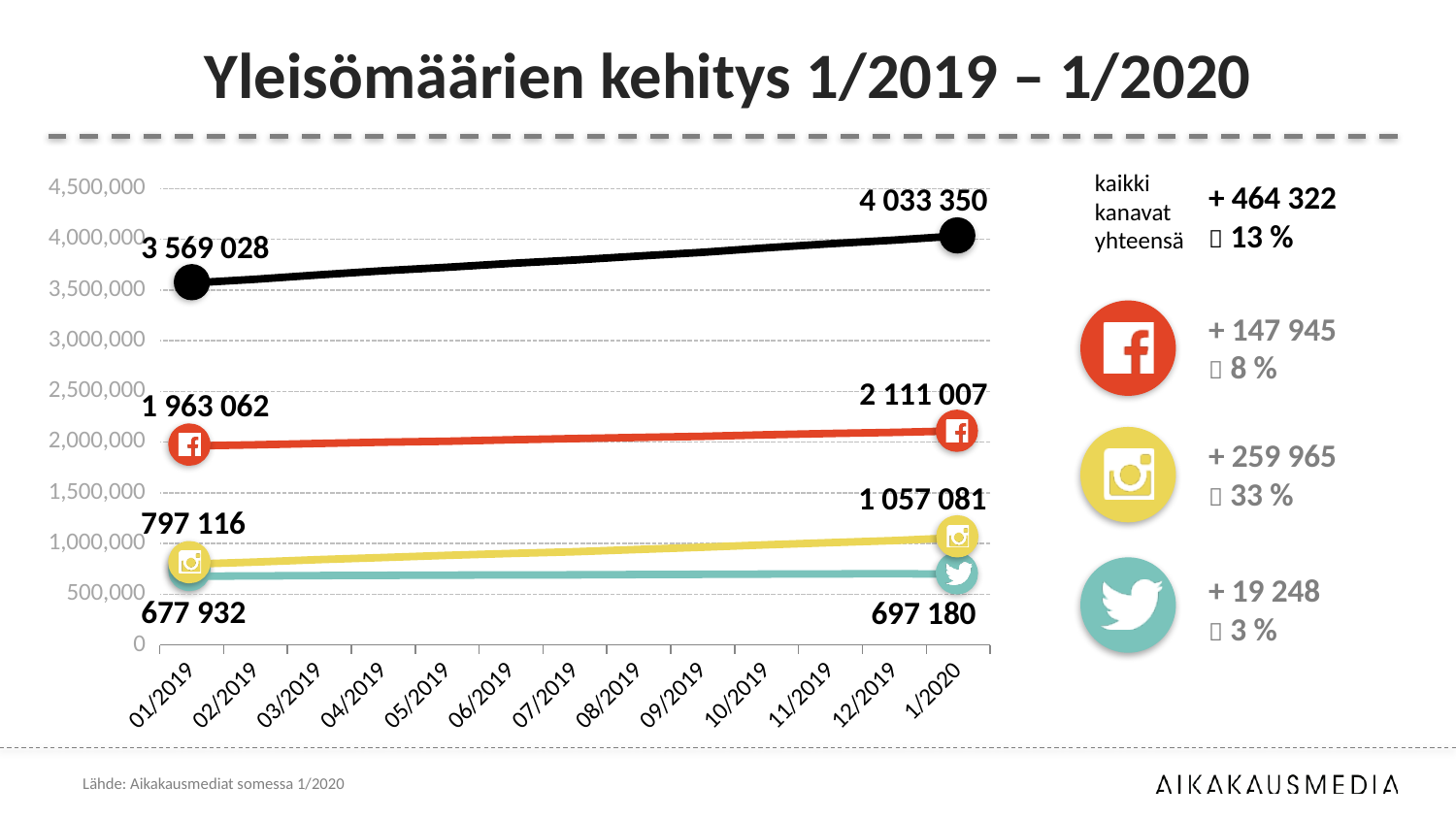
Which line has the lowest value at 1/2020? Twitter (697 180) At 1/2020, which is larger: the Facebook value or the Instagram value? Facebook (2 111 007) By how much did the Instagram line increase from 01/2019 to 1/2020? 259 965 How many time points are labelled on the x axis? 13 What is the value of the Twitter line at 01/2019? 677 932 What type of chart is shown on the slide? Line chart What is the value of the black (total) line at 1/2020? 4 033 350 By how much did the black total line increase from 01/2019 to 1/2020? 464 322 What is the value of the Facebook line at 01/2019? 1 963 062 Does the Twitter line rise or fall from 01/2019 to 1/2020? Rises Which line has the highest value at 01/2019? The black total line (3 569 028) What is the value of the Instagram line at 1/2020? 1 057 081